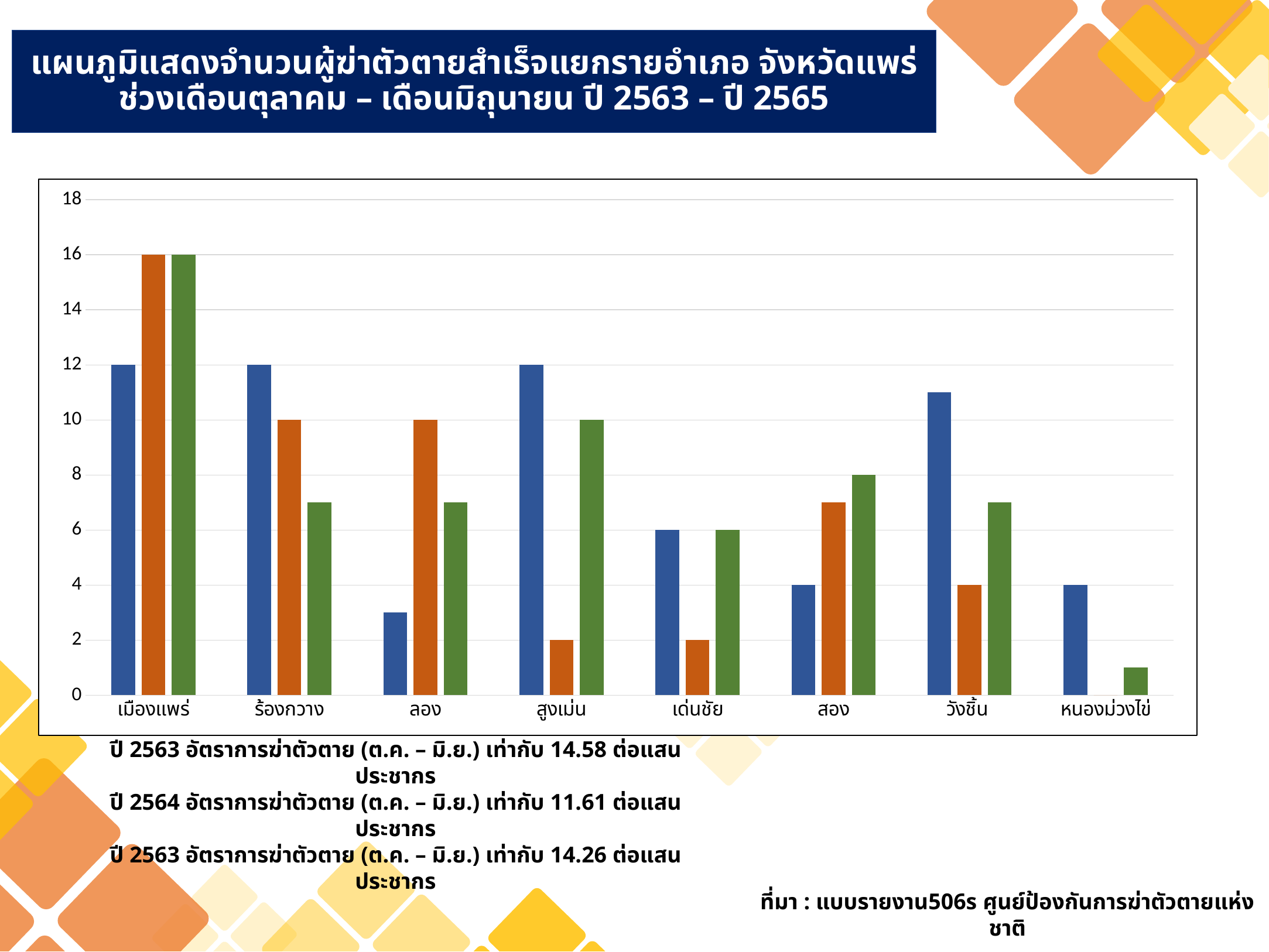
For เด่นชัย, which is larger: the blue bar or the orange bar? the blue bar Is the value of the blue bar for ลอง greater or less than 4? less What is the value of the orange bar for ร้องกวาง? 10 How many districts (categories) are shown on the x axis of the chart? 8 What is the value of the blue bar for เมืองแพร่? 12 What is the value of the blue bar for สูงเม่น? 12 Which district has the lowest green bar? หนองม่วงไข่ What is the value of the orange bar for เมืองแพร่? 16 Is the value of the blue bar for วังชิ้น greater or less than 10? greater What kind of chart is shown on the slide? bar chart What is the difference between the orange bar and the blue bar for เมืองแพร่? 4 Which district has the highest orange bar? เมืองแพร่